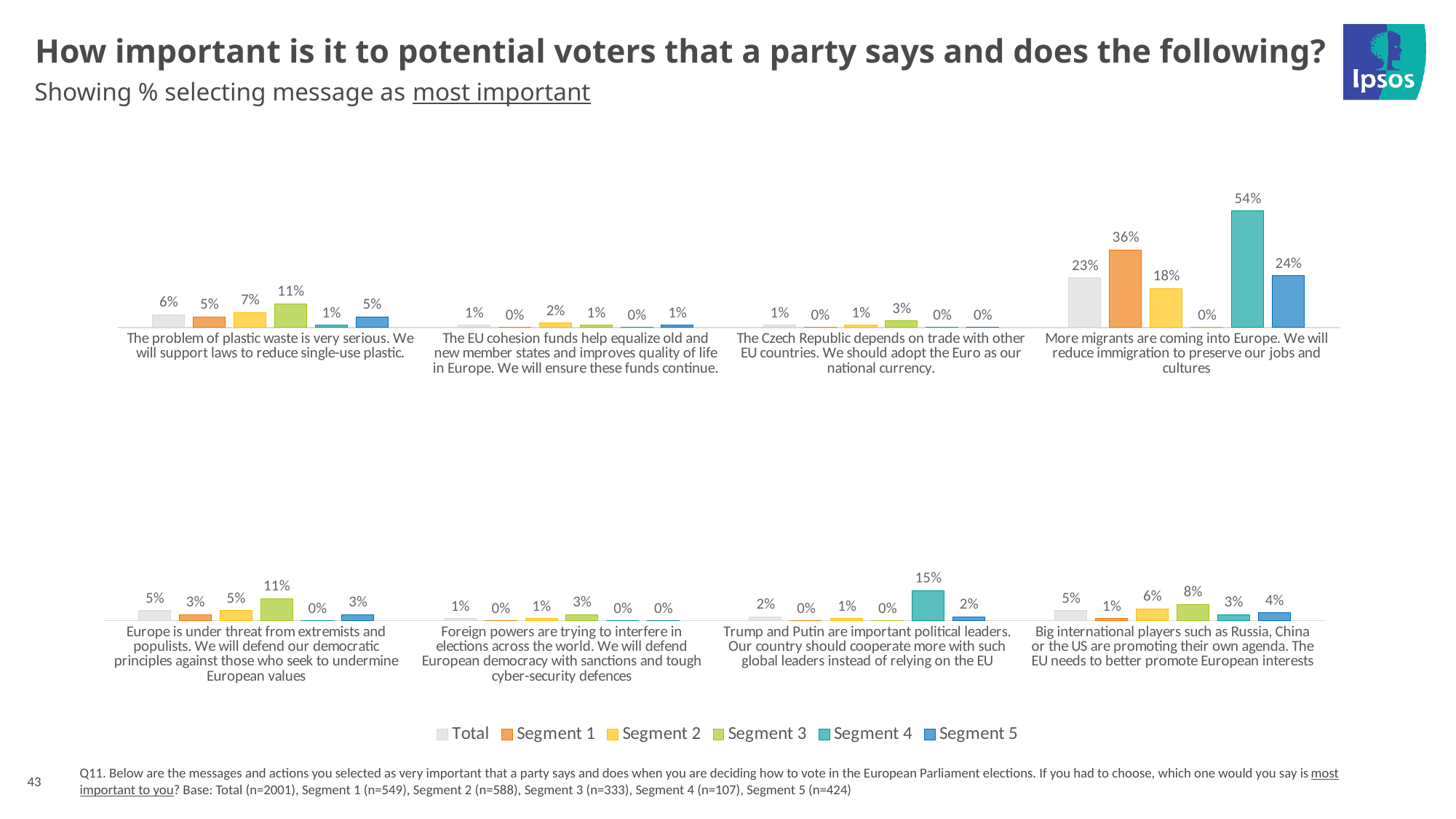
What colour represents Segment 4 in the legend? Teal Which segment has the highest value for the message about reducing immigration to preserve jobs and cultures? Segment 4 How many series does the legend list? 6 For the message about big international players such as Russia, China or the US, which is larger: the Segment 3 value or the Segment 2 value? Segment 3 What is the Segment 4 value for the message about Trump and Putin being important political leaders? 15% Which segment has the lowest value for the message about reducing immigration to preserve jobs and cultures? Segment 3 How many message categories are shown on the chart? 8 What percentage of Segment 3 selected the message "Europe is under threat from extremists and populists..." as most important? 11% What kind of chart is shown on the slide? Bar chart What is the Total value for the message "The problem of plastic waste is very serious. We will support laws to reduce single-use plastic."? 6% What percentage of Segment 4 selected the message about reducing immigration ("More migrants are coming into Europe...") as most important? 54% What is the difference between the Segment 1 and Segment 2 values for the message about reducing immigration? 18%